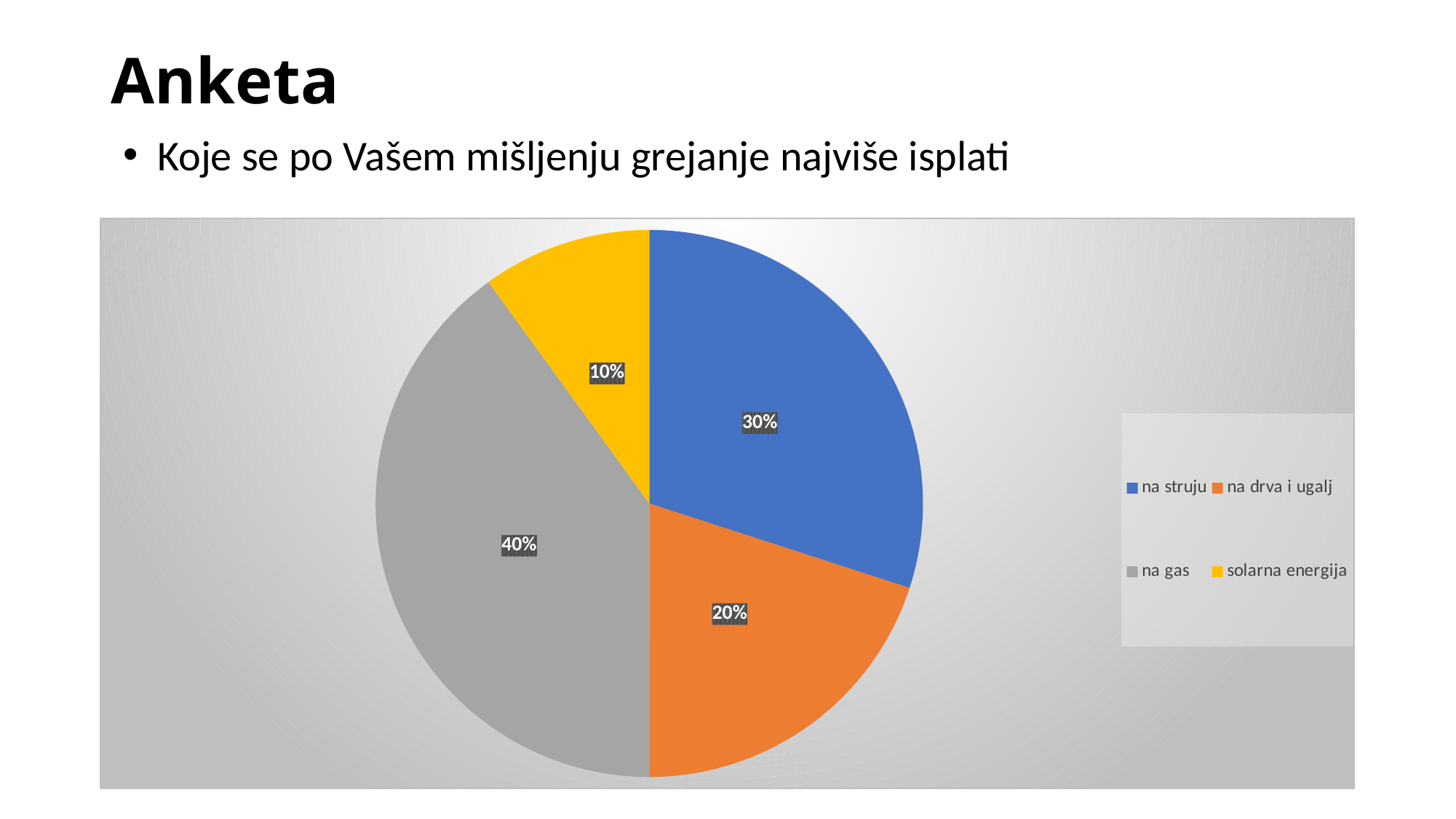
What share of the pie does "solarna energija" have? 10% Which colour represents "solarna energija" in the legend? yellow Which is larger, the share for "na struju" or the share for "na drva i ugalj"? na struju What is the difference between the shares for "na gas" and "na struju"? 10% What is the difference between the shares for "na drva i ugalj" and "solarna energija"? 10% Which category has the largest slice of the pie? na gas What kind of chart is shown on the slide? pie chart What share of the pie does "na struju" have? 30% What share of the pie does "na gas" have? 40% How many categories does the pie chart have? 4 Which category has the smallest slice of the pie? solarna energija